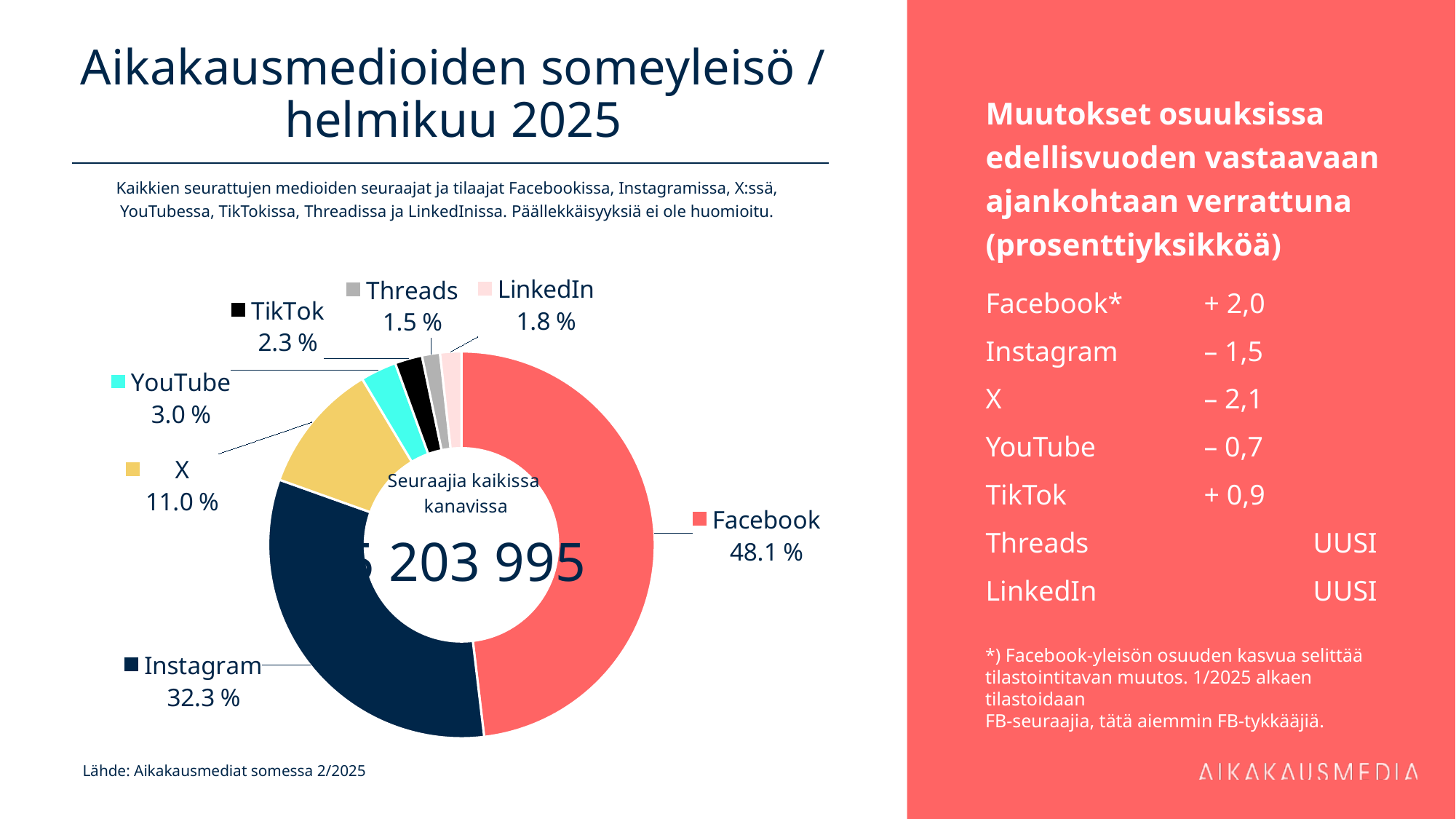
What share does X have in the chart? 11.0 % What colour is the Facebook slice in the chart? red (coral) Which channel has the smallest share in the chart? Threads What kind of chart is shown on the slide? pie chart (donut) Which channel has the largest share in the chart? Facebook How many channels (slices) are shown in the chart? 7 What share of the social media audience does Instagram have? 32.3 % Which has a larger share, TikTok or LinkedIn? TikTok What share does YouTube have in the chart? 3.0 % What is the difference in percentage points between Facebook's and Instagram's shares? 15.8 What share does LinkedIn have in the chart? 1.8 % What share of the social media audience does Facebook have? 48.1 %